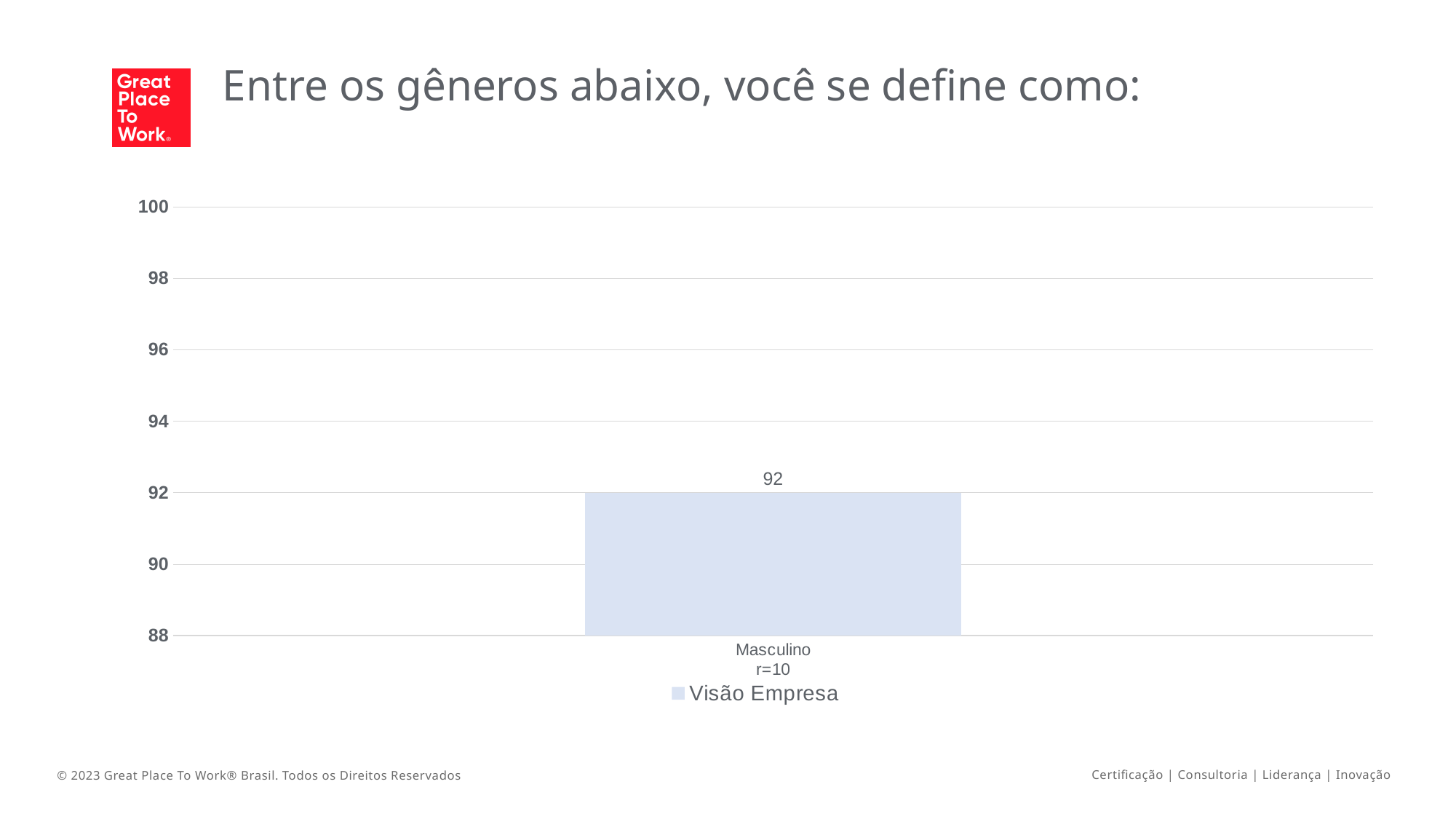
Is the value for Masculino greater or less than 94? less How many categories are plotted in the chart? 1 How many series does the legend list? 1 What kind of chart is shown on the slide? bar chart What is the highest value shown on the vertical axis? 100 What is the lowest value shown on the vertical axis? 88 What is the number of respondents (r) shown for the Masculino category? r=10 What is the value for Masculino? 92 Is the value for Masculino greater or less than 90? greater What is the title of the slide containing the chart? Entre os gêneros abaixo, você se define como: What is the name of the series shown in the legend? Visão Empresa